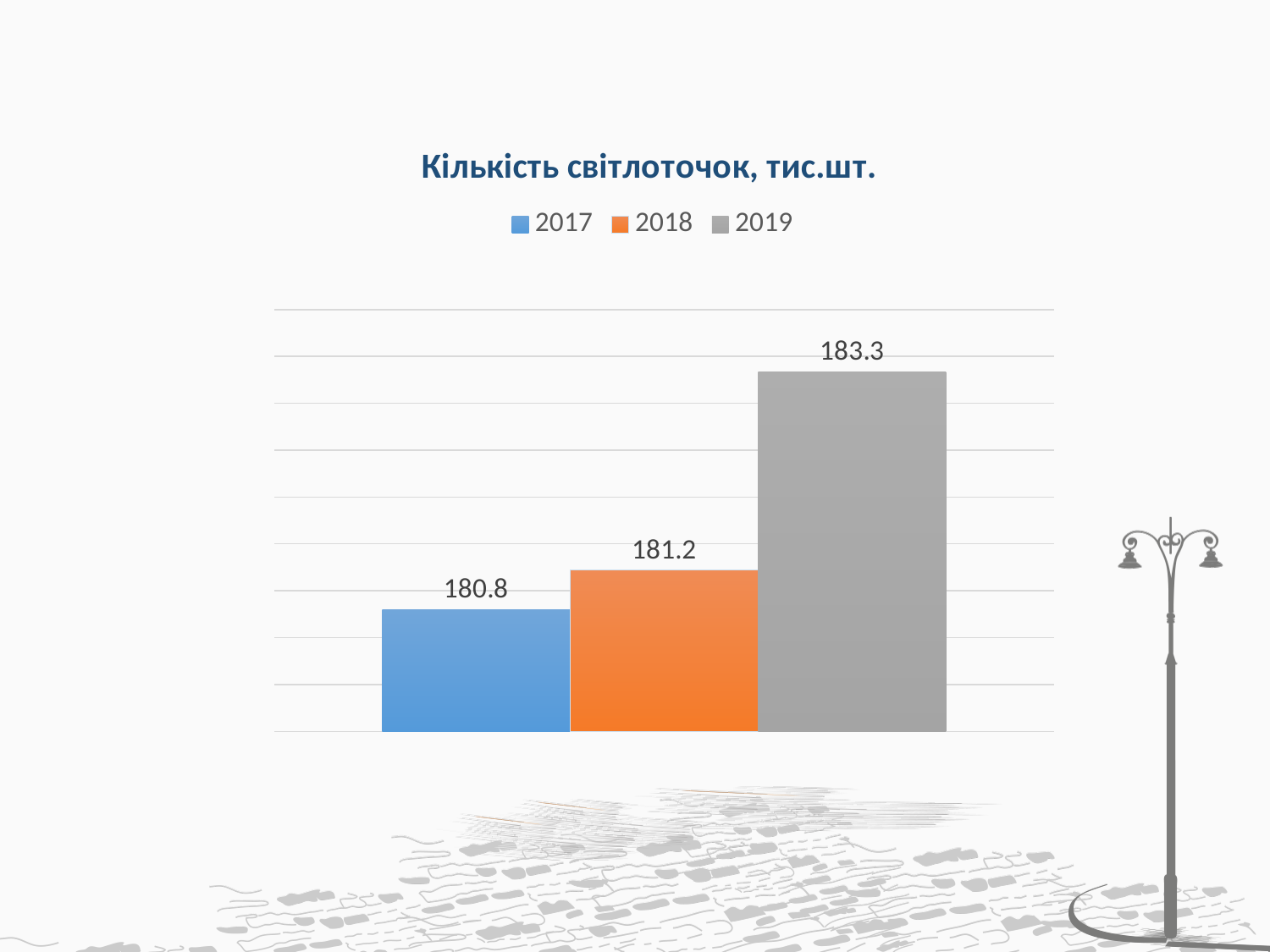
What is the value for 2018? 181.2 How many series does the legend list? 3 Which year has the lowest value? 2017 What is the title of the chart? Кількість світлоточок, тис.шт. What is the difference between the values for 2019 and 2017? 2.5 Which year has the highest value? 2019 Which is larger, the value for 2018 or the value for 2019? 2019 Do the values rise or fall from 2017 to 2019? rise What is the value for 2017? 180.8 What is the difference between the values for 2018 and 2017? 0.4 What kind of chart is shown on the slide? bar chart What is the value for 2019? 183.3